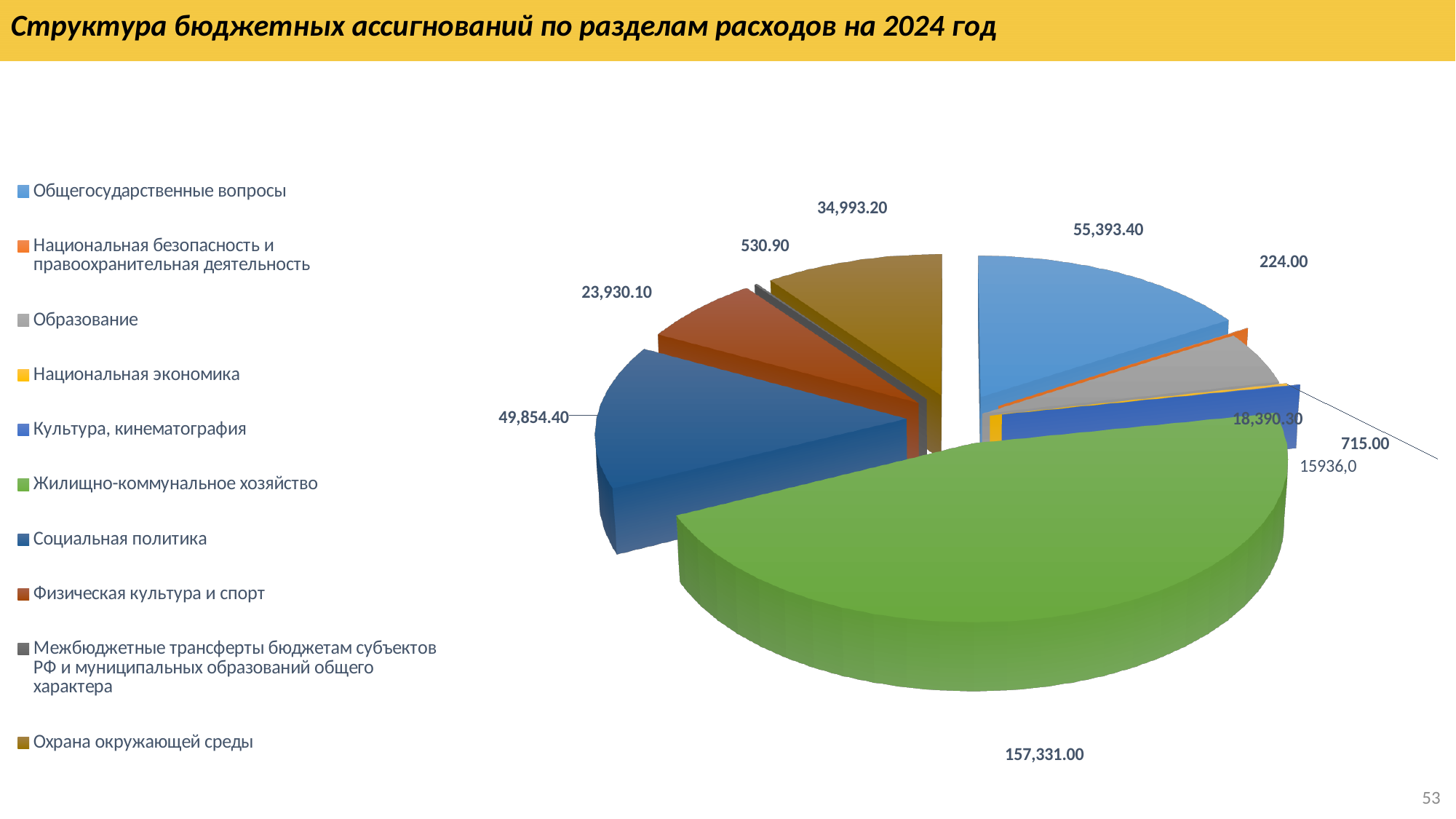
What is the difference between the values for Общегосударственные вопросы and Социальная политика? 5,539.00 What is the value for Охрана окружающей среды? 34,993.20 Which category has the smallest value in the pie chart? Национальная безопасность и правоохранительная деятельность What is the title of the slide containing the pie chart? Структура бюджетных ассигнований по разделам расходов на 2024 год What kind of chart is shown on the slide? pie chart Which is larger: the value for Охрана окружающей среды or the value for Физическая культура и спорт? Охрана окружающей среды What is the value for Жилищно-коммунальное хозяйство? 157,331.00 What is the value for Физическая культура и спорт? 23,930.10 What is the value for Социальная политика? 49,854.40 How many categories does the legend of the pie chart list? 10 What is the value for Общегосударственные вопросы? 55,393.40 Which category has the largest slice of the pie? Жилищно-коммунальное хозяйство